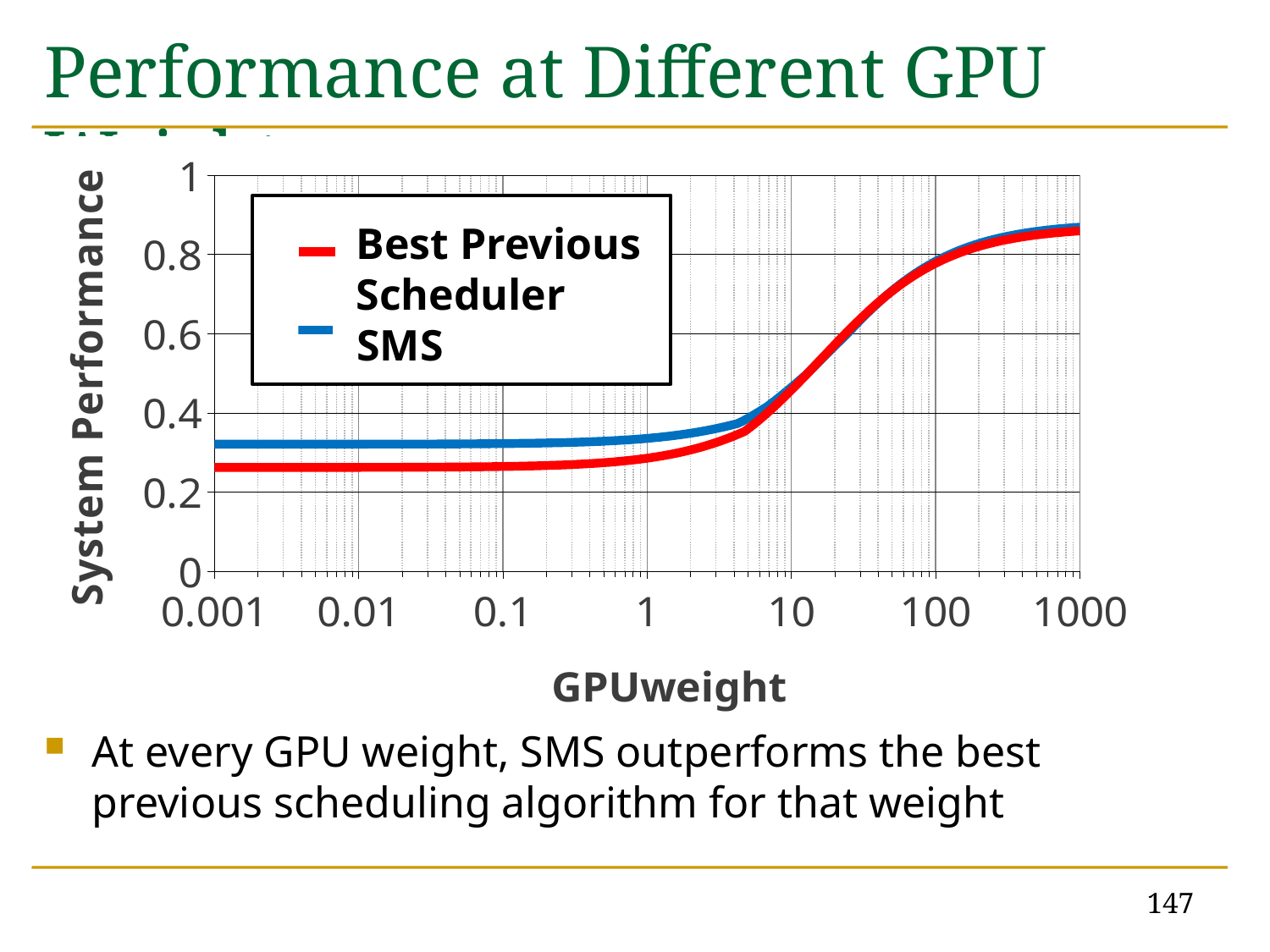
Is the System Performance of Best Previous Scheduler at a GPUweight of 1 greater or less than 0.4? less What kind of chart is shown on the slide? line chart Is the System Performance of SMS at a GPUweight of 0.001 greater or less than 0.4? less Is the System Performance of SMS at a GPUweight of 1000 greater or less than 0.8? greater How many series does the legend list? 2 Do the System Performance values rise or fall as GPUweight increases? rise At a GPUweight of 0.001, which series has the higher System Performance, SMS or Best Previous Scheduler? SMS Which series is drawn in red? Best Previous Scheduler What is the label of the x axis? GPUweight